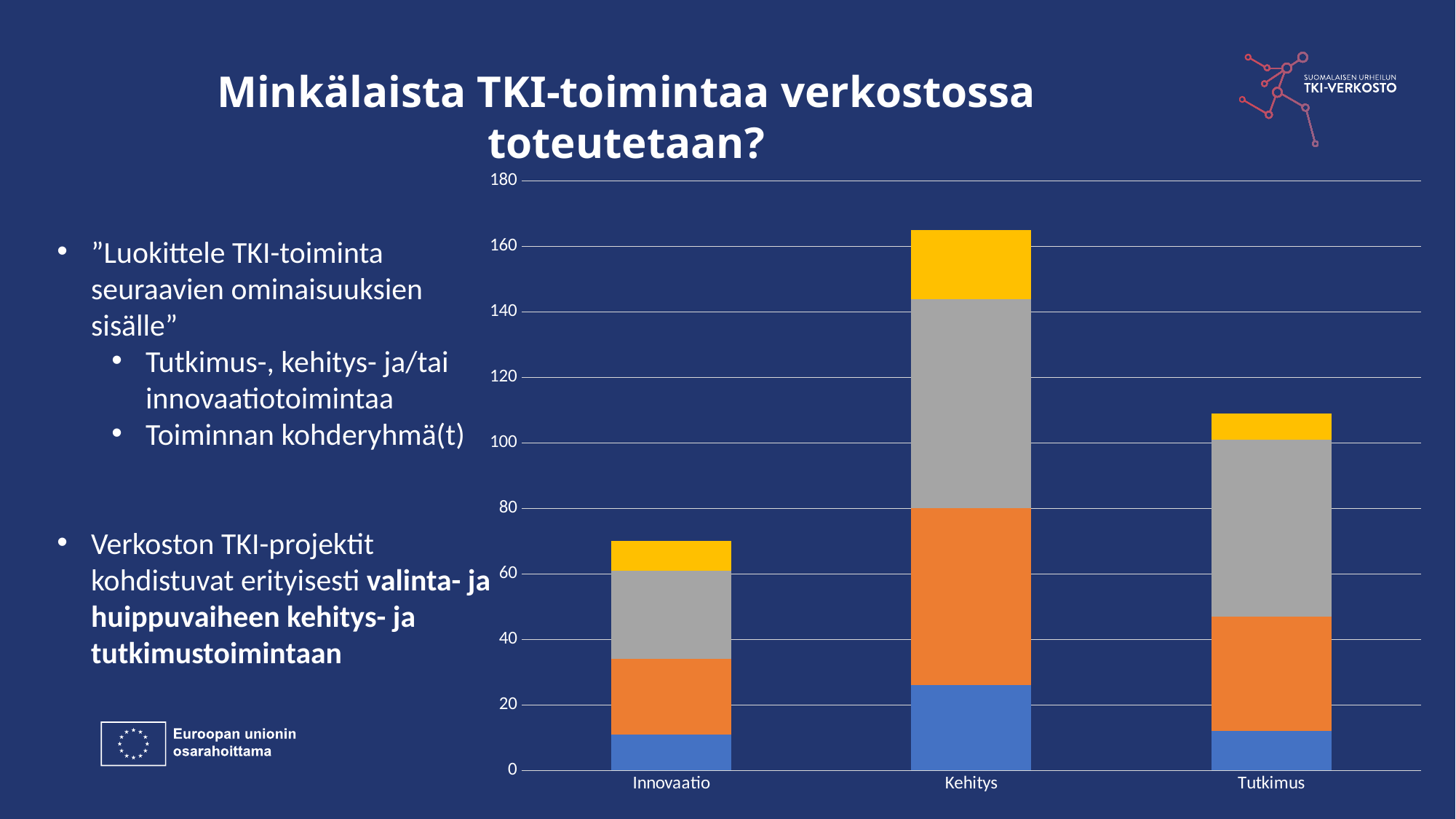
Which category has the tallest stacked bar? Kehitys Is the total height of the Tutkimus bar greater or less than 100? greater Is the total height of the Innovaatio bar greater or less than 60? greater Which category has the shortest stacked bar? Innovaatio Is the total height of the Innovaatio bar greater or less than 80? less What kind of chart is shown on the slide? Stacked bar chart What is the highest value shown on the y axis of the chart? 180 How many coloured segments make up each stacked bar? 4 Which stacked bar is taller, Innovaatio or Tutkimus? Tutkimus How many categories are shown on the x axis of the chart? 3 Which stacked bar is taller, Kehitys or Tutkimus? Kehitys